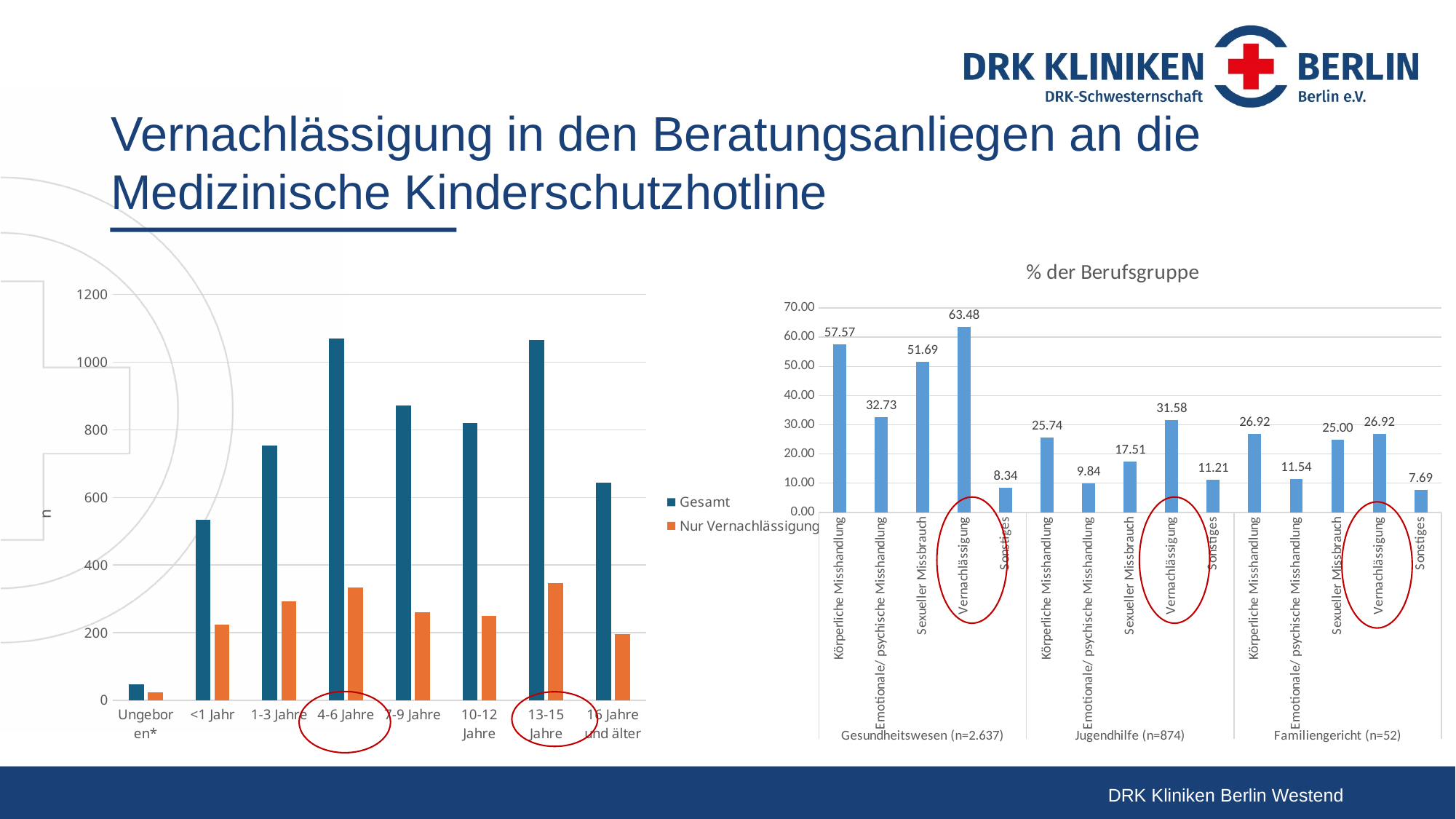
What kind of chart is the chart on the left side of the slide? Bar chart In the chart titled '% der Berufsgruppe', which bar has the lowest value? Sonstiges (Familiengericht) In the chart on the left side of the slide, which age group has the lowest Gesamt value? Ungeboren* In the chart titled '% der Berufsgruppe', what is the value for Sexueller Missbrauch in the Jugendhilfe group? 17.51 In the chart titled '% der Berufsgruppe', what is the difference between the Vernachlässigung values for Gesundheitswesen and Jugendhilfe? 31.90 In the chart on the left side of the slide, is the Gesamt value for 4-6 Jahre greater or less than 1000? greater In the chart on the left side of the slide, how many series does the legend list? 2 In the chart titled '% der Berufsgruppe', how many bars are plotted in total? 15 In the chart titled '% der Berufsgruppe', which is larger: Körperliche Misshandlung in Jugendhilfe or Sexueller Missbrauch in Familiengericht? Körperliche Misshandlung in Jugendhilfe In the chart titled '% der Berufsgruppe', what is the value for Emotionale/ psychische Misshandlung in the Familiengericht group? 11.54 In the chart titled '% der Berufsgruppe', which bar has the highest value? Vernachlässigung (Gesundheitswesen) In the chart titled '% der Berufsgruppe', what is the value for Vernachlässigung in the Gesundheitswesen group? 63.48